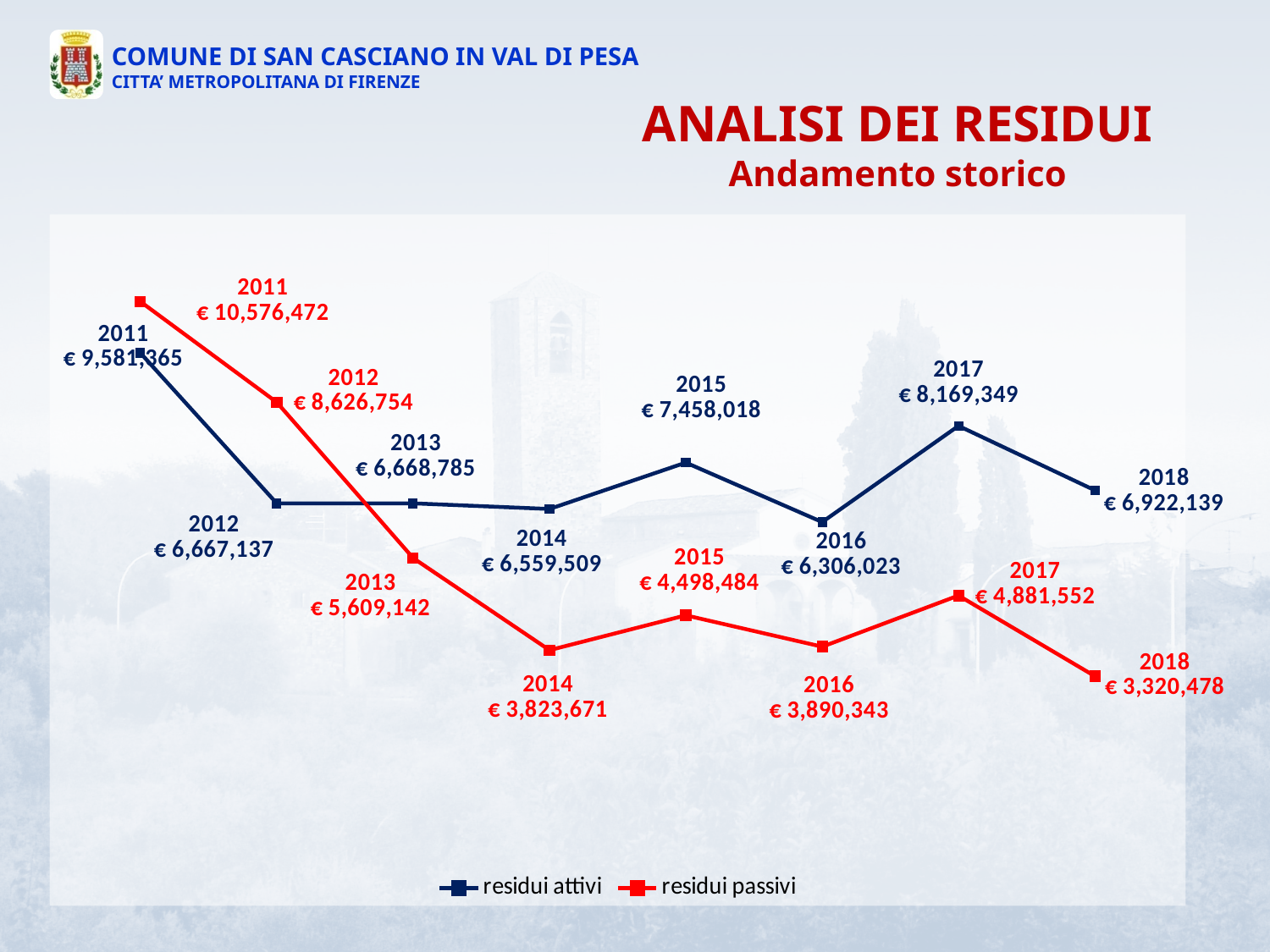
Which is larger in 2015: residui attivi or residui passivi? residui attivi How many years are plotted on the chart? 8 In which year are residui attivi lowest? 2016 How many series does the legend list? 2 What kind of chart is shown on the slide? line chart In which year are residui passivi highest? 2011 What is the value of residui attivi in 2016? € 6,306,023 In which year are residui passivi lowest? 2018 What is the value of residui attivi in 2017? € 8,169,349 What is the value of residui passivi in 2011? € 10,576,472 What is the value of residui passivi in 2014? € 3,823,671 What is the difference between residui attivi and residui passivi in 2018? € 3,601,661